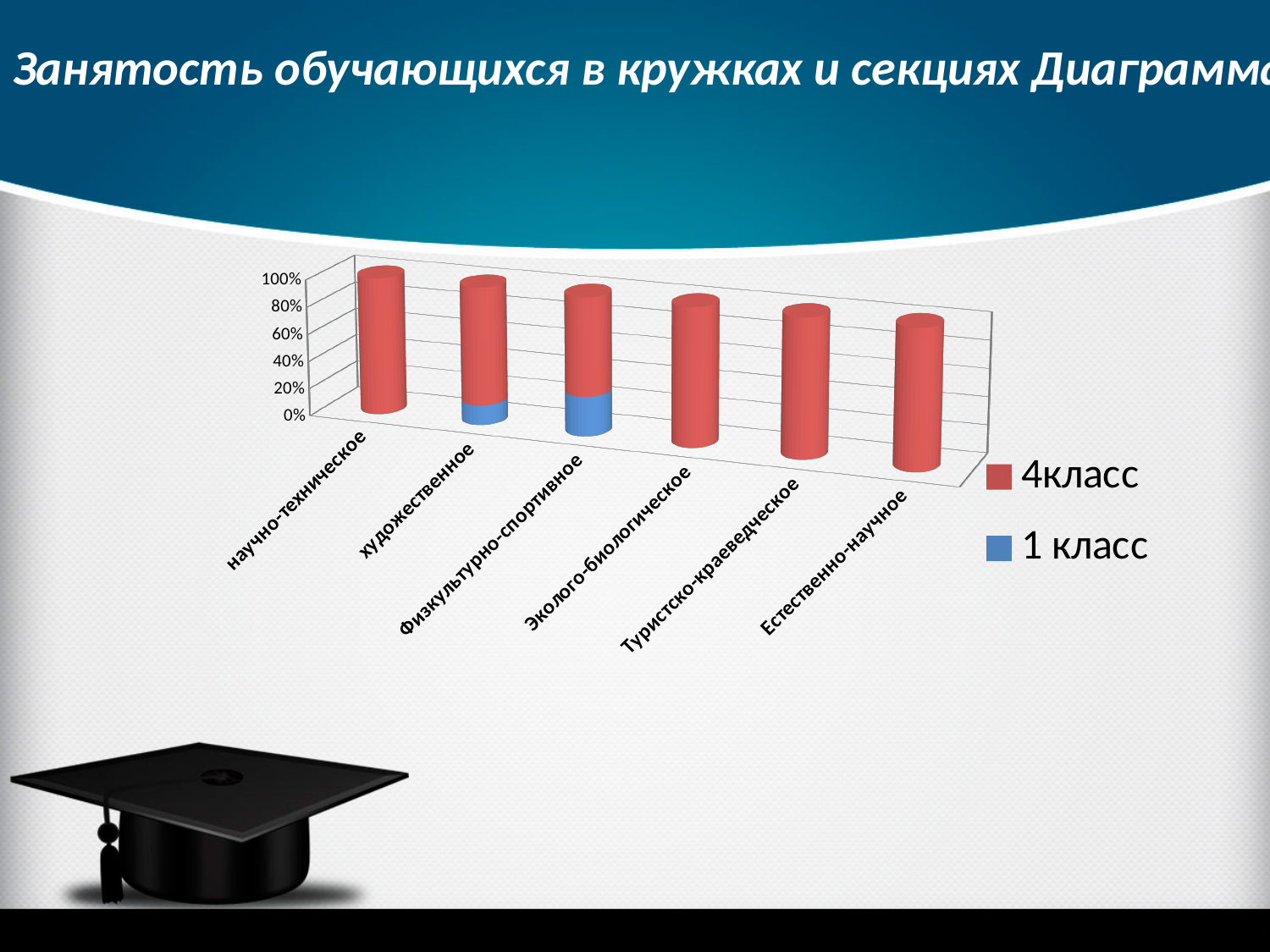
How many categories are shown along the x axis of the chart? 6 Is the "1 класс" value for Физкультурно-спортивное greater or less than 60%? less What is the last category on the x axis of the chart? Естественно-научное Which category has the larger blue "1 класс" segment: художественное or Физкультурно-спортивное? Физкультурно-спортивное In which categories does the chart show a visible blue "1 класс" segment? художественное and Физкультурно-спортивное Is the "4класс" value for научно-техническое greater or less than 60%? greater What are the two series listed in the chart's legend? 4класс and 1 класс What is the highest value shown on the chart's vertical axis? 100% How many series does the chart's legend list? 2 What is the first category on the x axis of the chart? научно-техническое What kind of chart is shown on the slide? bar chart Which colour represents the series "1 класс" in the chart? blue